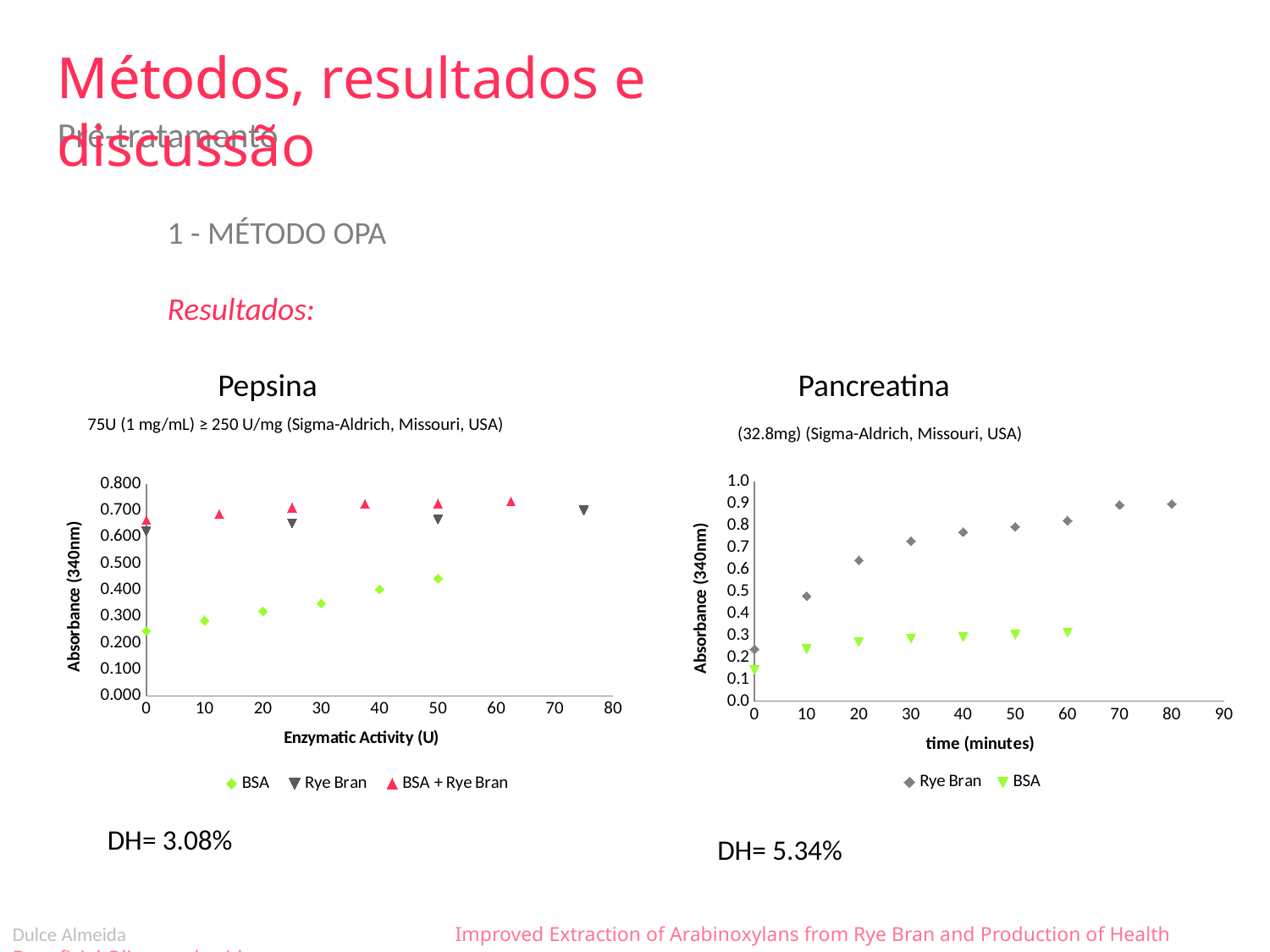
In the Pancreatina chart, how many data points does the Rye Bran series have? 9 In the Pepsina chart, does the BSA series rise or fall as enzymatic activity increases? rise In the Pepsina chart, is the BSA value at 50 U greater or less than 0.500? less In the Pancreatina chart, does the Rye Bran series rise or fall over time? rise How many series does the legend of the Pepsina chart list? 3 What kind of chart is the Pepsina chart? scatter chart In the Pancreatina chart, is the Rye Bran value at 80 minutes greater or less than 0.8? greater In the Pancreatina chart, is the BSA value at 60 minutes greater or less than 0.5? less How many series does the legend of the Pancreatina chart list? 2 In the Pepsina chart, at 50 U, which is larger: BSA or BSA + Rye Bran? BSA + Rye Bran What is the x-axis title of the Pancreatina chart? time (minutes) In the Pancreatina chart, at 60 minutes, which series has the larger absorbance: Rye Bran or BSA? Rye Bran